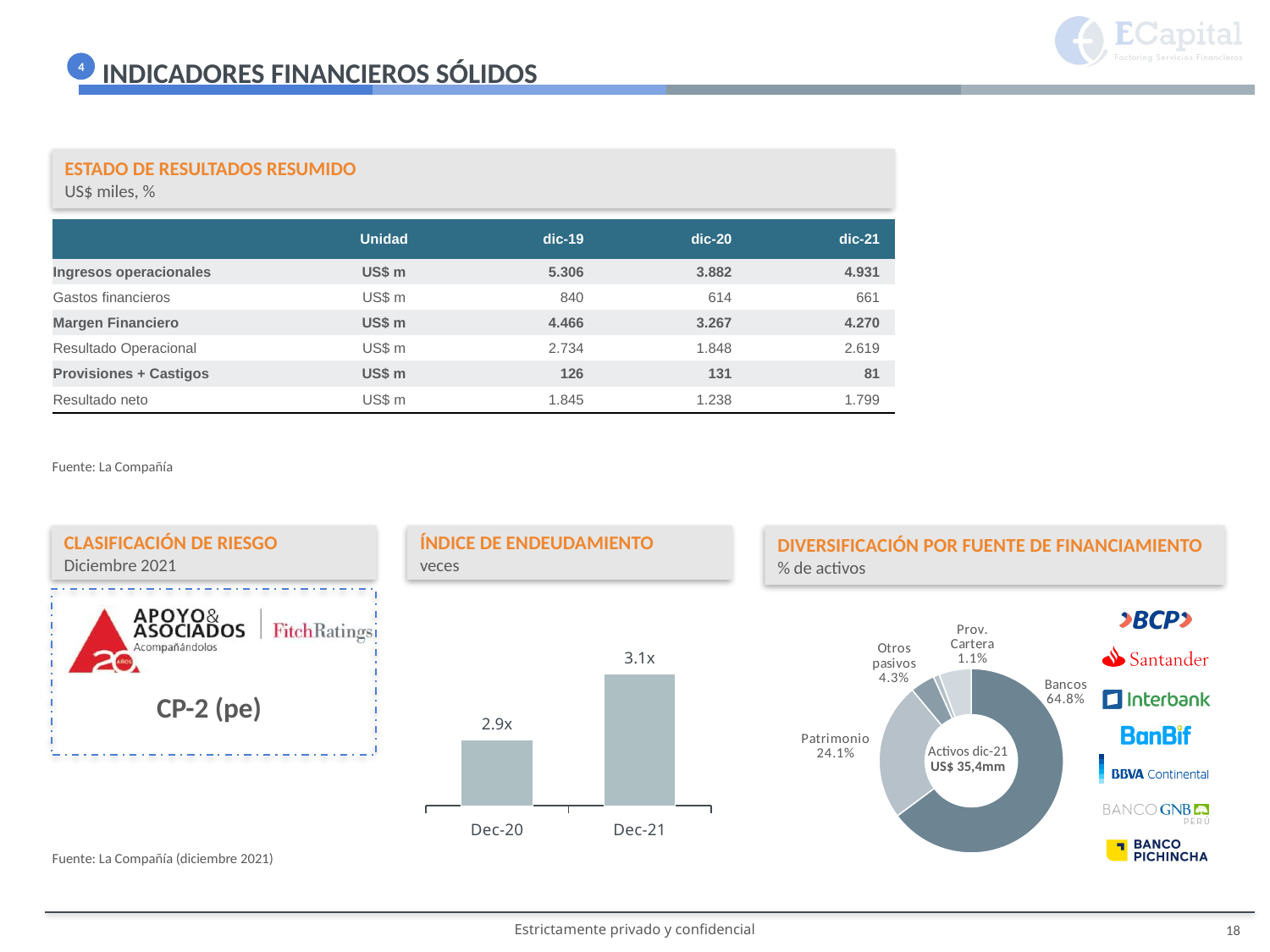
In the ÍNDICE DE ENDEUDAMIENTO chart, by how much did the value change from Dec-20 to Dec-21? 0.2x What kind of chart is the ÍNDICE DE ENDEUDAMIENTO chart? bar chart In the ÍNDICE DE ENDEUDAMIENTO chart, what is the value for Dec-20? 2.9x In the ÍNDICE DE ENDEUDAMIENTO chart, which period has the higher value? Dec-21 What total assets value is shown in the centre of the DIVERSIFICACIÓN POR FUENTE DE FINANCIAMIENTO chart? US$ 35,4mm In the DIVERSIFICACIÓN POR FUENTE DE FINANCIAMIENTO chart, what share corresponds to Patrimonio? 24.1% In the DIVERSIFICACIÓN POR FUENTE DE FINANCIAMIENTO chart, which labelled source has the smallest share? Prov. Cartera In the DIVERSIFICACIÓN POR FUENTE DE FINANCIAMIENTO chart, which is larger: Otros pasivos or Prov. Cartera? Otros pasivos How many bars are shown in the ÍNDICE DE ENDEUDAMIENTO chart? 2 In the ÍNDICE DE ENDEUDAMIENTO chart, what is the value for Dec-21? 3.1x In the ÍNDICE DE ENDEUDAMIENTO chart, does the value rise or fall from Dec-20 to Dec-21? rise In the DIVERSIFICACIÓN POR FUENTE DE FINANCIAMIENTO chart, what share corresponds to Bancos? 64.8%